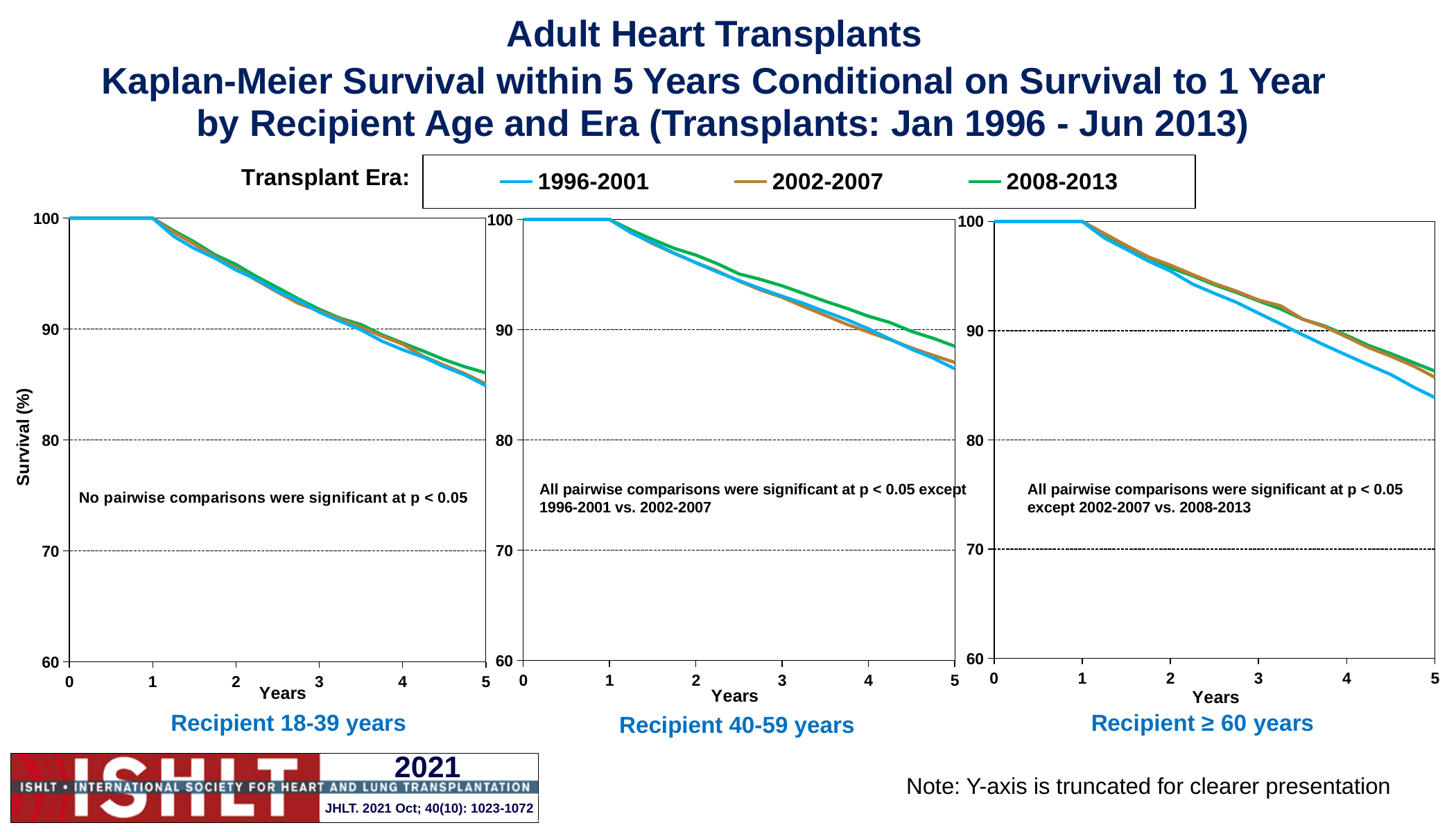
In the 'Recipient 40-59 years' chart, which is higher at year 5: 2008-2013 or 1996-2001? 2008-2013 In the 'Recipient 40-59 years' chart, is the value for 2008-2013 at year 5 greater or less than 90? less In the 'Recipient ≥ 60 years' chart, which is higher at year 5: 1996-2001 or 2008-2013? 2008-2013 In the 'Recipient 40-59 years' chart, do the survival curves rise or fall as years increase? fall What is the label of the y-axis on the charts? Survival (%) Which era is drawn in green in the legend? 2008-2013 How many transplant eras does the legend list? 3 In the 'Recipient ≥ 60 years' chart, which era has the lowest survival at year 5? 1996-2001 What kind of chart is used for the 'Recipient 18-39 years' panel? line chart How many separate survival charts are shown on the slide? 3 In the 'Recipient 18-39 years' chart, is the value for 2008-2013 at year 3 greater or less than 90? greater In the 'Recipient ≥ 60 years' chart, is the value for 1996-2001 at year 5 greater or less than 90? less